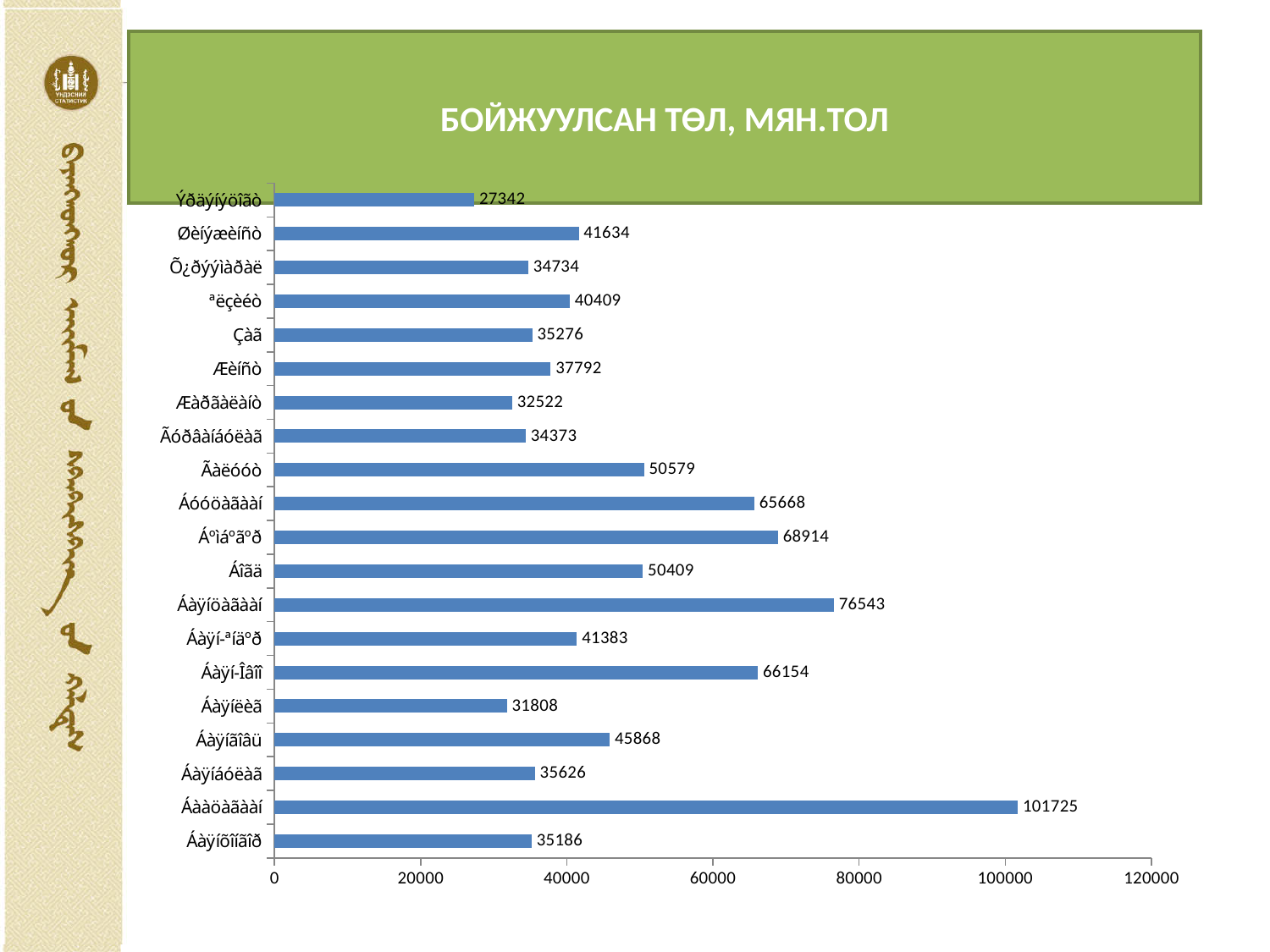
What type of chart is shown on the slide? bar chart What is the value of the second bar from the bottom? 101725 What is the value of the shortest bar in the chart? 27342 What is the title of the chart? БОЙЖУУЛСАН ТӨЛ, МЯН.ТОЛ What is the value of the longest bar in the chart? 101725 Is the value of the second bar from the bottom greater or less than 100000? greater What is the difference between the longest bar (101725) and the shortest bar (27342)? 74383 What is the value of the bottom bar in the chart? 35186 Is the value of the topmost bar greater or less than 40000? less Which is larger: the bar labelled 76543 or the bar labelled 68914? 76543 How many bars (categories) does the chart show? 20 What is the value of the topmost bar in the chart? 27342